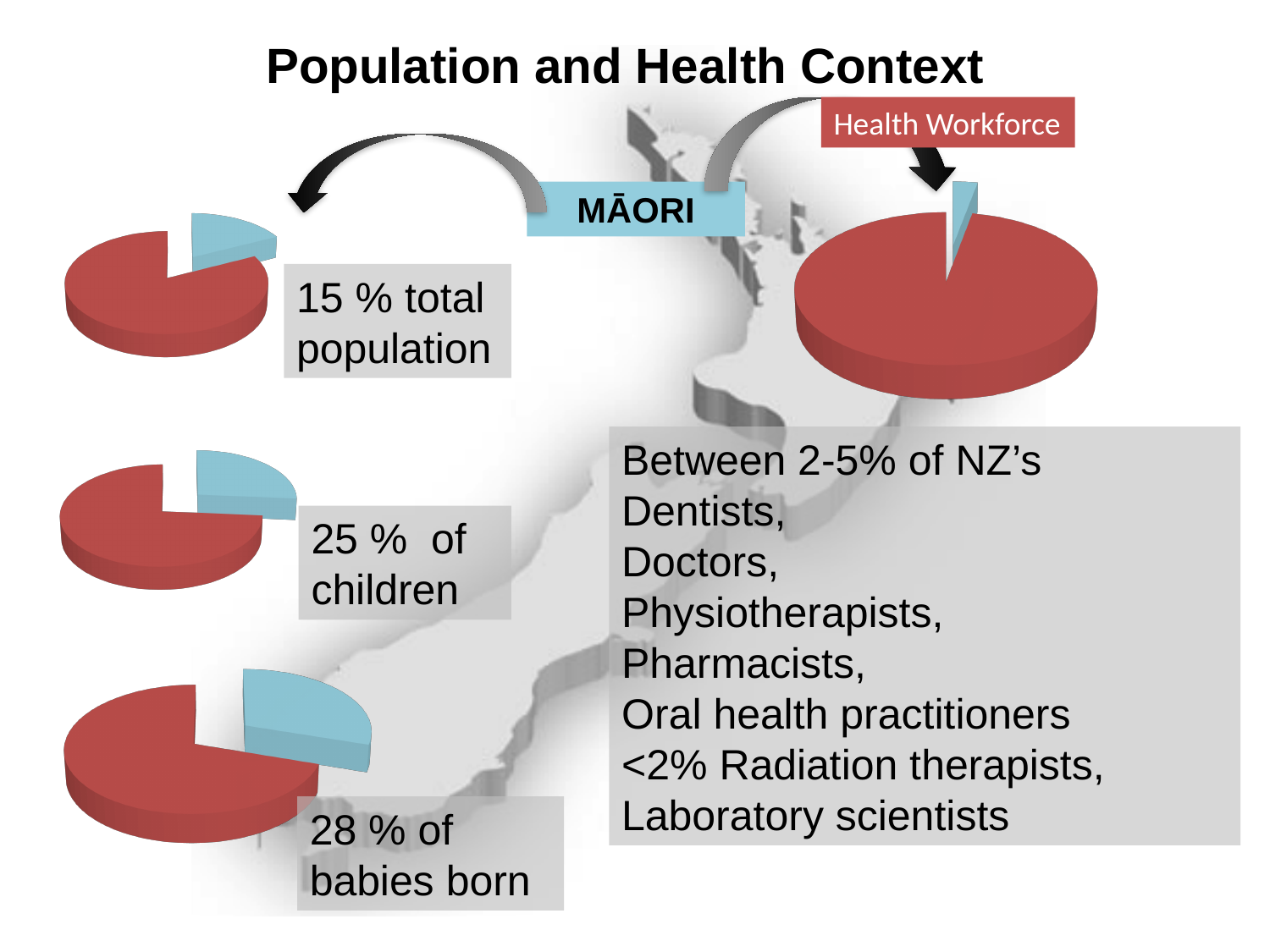
Among the three labelled pie charts on the left, which shows the largest Māori share? Babies born (28 %) How many pie charts are on the slide? 4 What is the difference between the Māori share of children and the Māori share of the total population? 10 % According to the bottom-left pie chart, what percentage of babies born are Māori? 28 % What colour is used for the Māori slice in the pie charts? Light blue Is the blue slice in the Health Workforce pie chart larger or smaller than the blue slice in the total population pie chart? Smaller What kind of charts are shown on the slide? Pie charts Is the Māori share larger for children or for babies born? Babies born What is the difference between the Māori share of babies born and the Māori share of the total population? 13 % According to the top-left pie chart, what percentage of the total population is Māori? 15 % According to the middle-left pie chart, what percentage of children are Māori? 25 % Among the three labelled pie charts on the left, which shows the smallest Māori share? Total population (15 %)